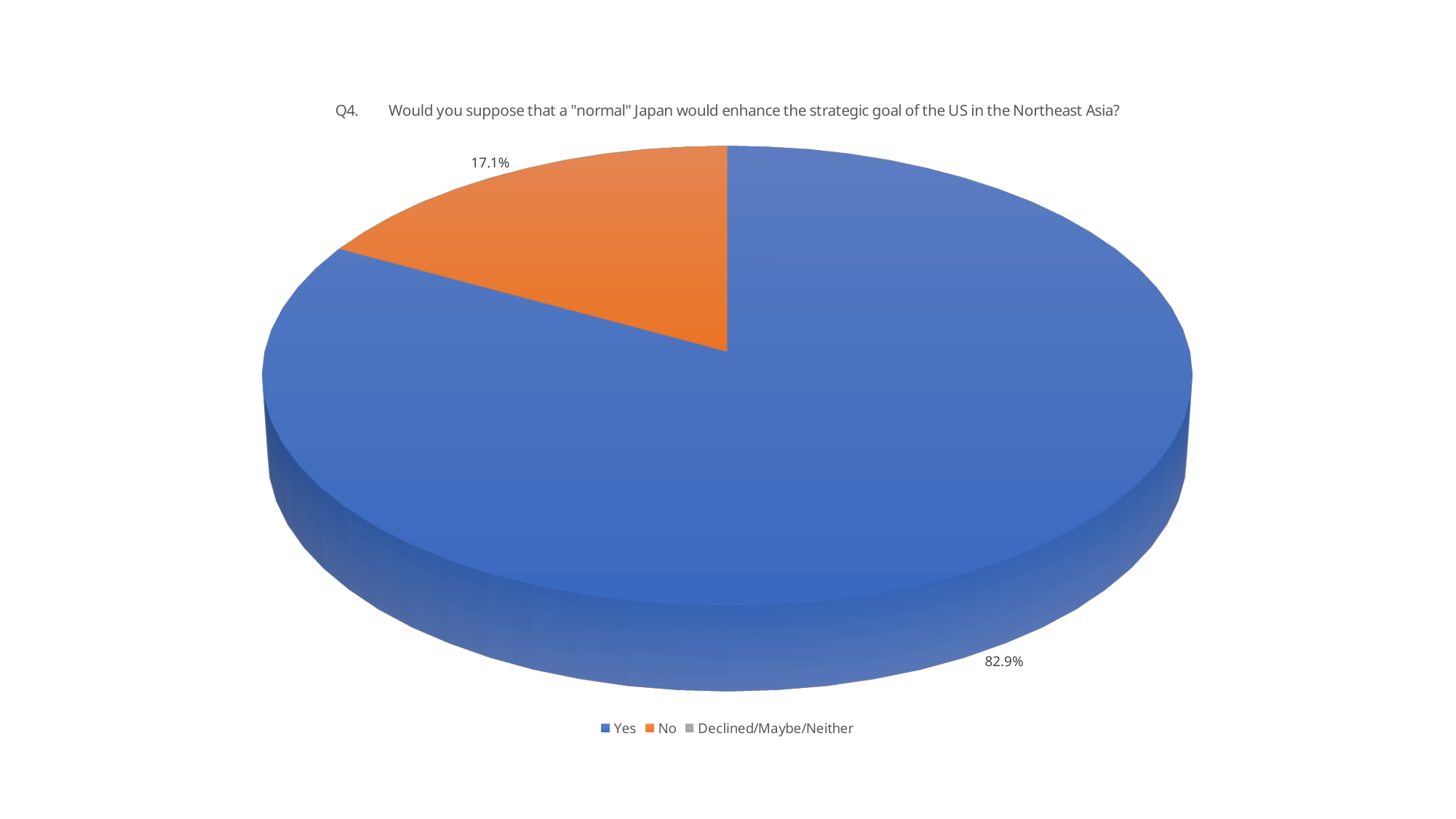
What is the title of the chart? Q4. Would you suppose that a "normal" Japan would enhance the strategic goal of the US in the Northeast Asia? Which response has the largest slice of the pie? Yes Which of the two visible slices is smaller, "Yes" or "No"? No How many slices are visible in the pie? 2 What share of the pie does the "No" slice represent? 17.1% How many entries does the legend list? 3 What is the difference in percentage points between the "Yes" share and the "No" share? 65.8 percentage points What share of the pie does the "Yes" slice represent? 82.9% Which is larger, the "Yes" share or the "No" share? Yes Is the "Yes" share greater or less than 50%? greater What colour is the "No" slice? Orange What kind of chart is shown on the slide? Pie chart